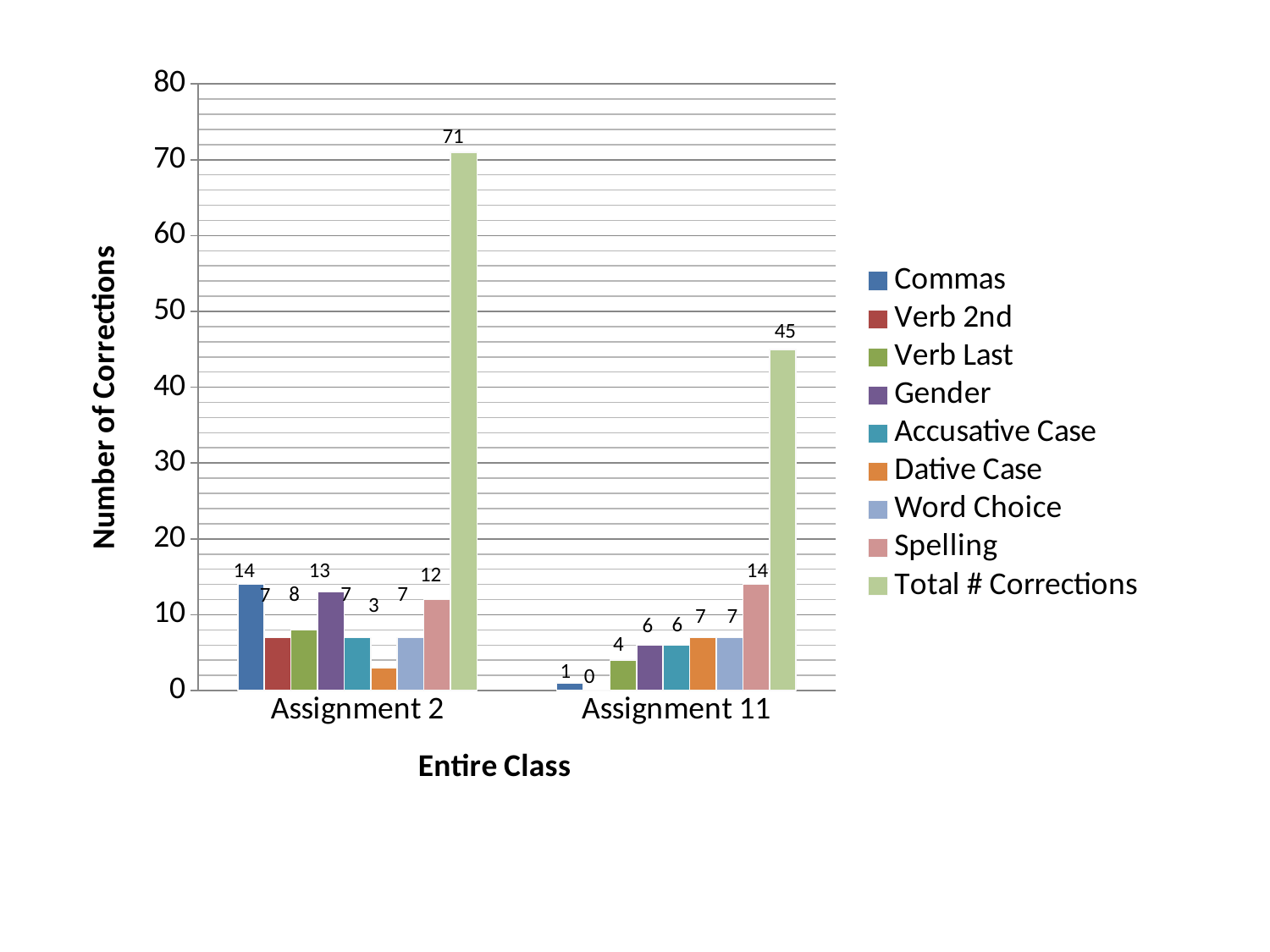
What is the Dative Case value for Assignment 2? 3 Which series has the lowest value for Assignment 11? Verb 2nd How many series does the legend list? 9 What is the Spelling value for Assignment 11? 14 How many assignment categories are shown on the x axis? 2 What is the Total # Corrections value for Assignment 11? 45 Excluding Total # Corrections, which series has the highest value for Assignment 2? Commas How many Commas corrections are shown for Assignment 2? 14 What is the Total # Corrections value for Assignment 2? 71 What type of chart is shown on the slide? Bar chart What is the difference between the Total # Corrections for Assignment 2 and Assignment 11? 26 Which is larger: the Gender value for Assignment 2 or the Gender value for Assignment 11? Assignment 2